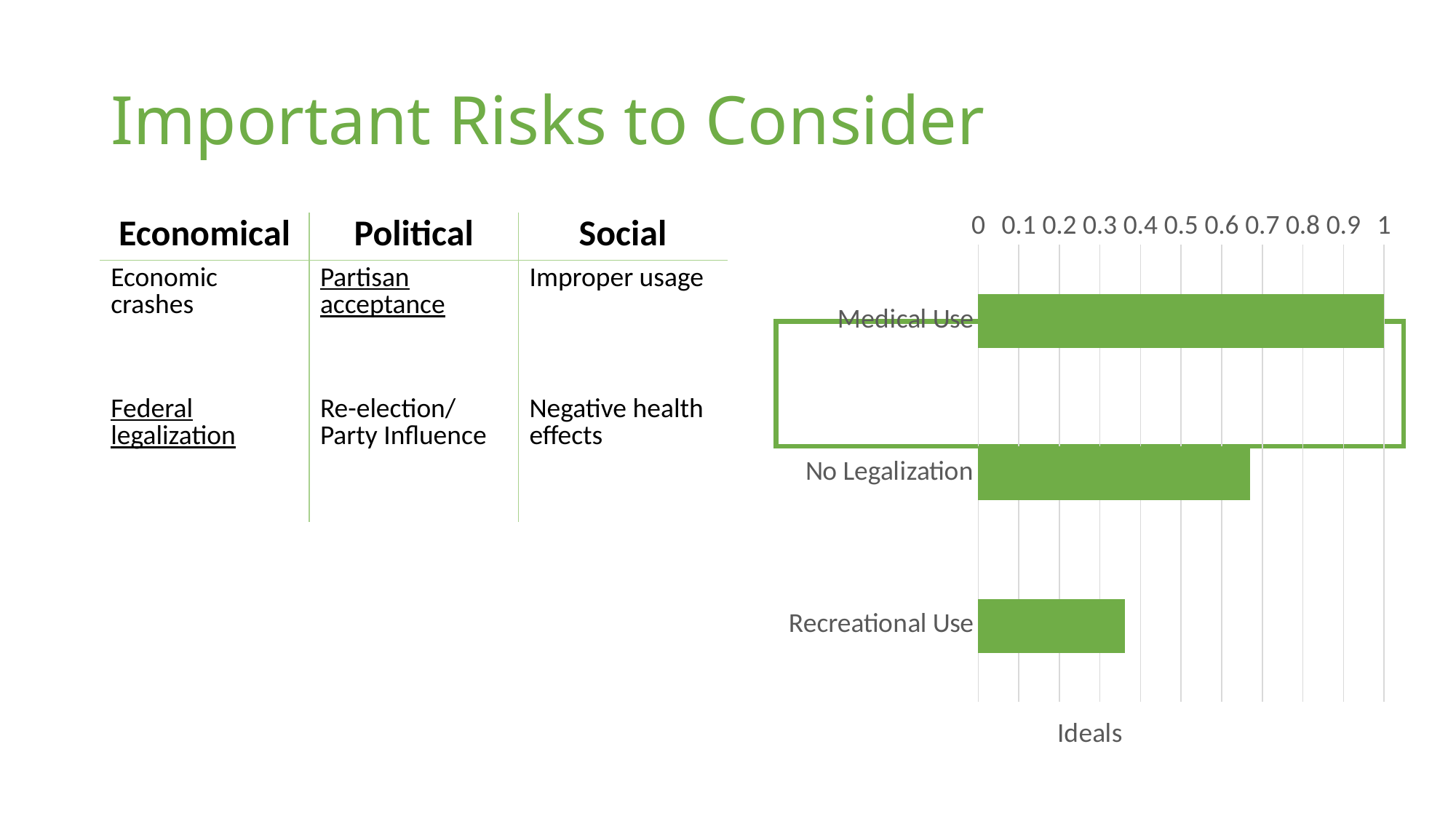
How many categories are plotted in the chart? 3 Which category has the highest value in the chart? Medical Use Is the value for Recreational Use greater or less than 0.3? greater Is the value for No Legalization greater or less than 0.5? greater Is the value for No Legalization greater or less than 0.8? less What is the value for Medical Use in the chart? 1 Which category has the lowest value in the chart? Recreational Use Which has a larger value, No Legalization or Recreational Use? No Legalization What colour are the bars in the chart? green What kind of chart is shown on the slide? bar chart